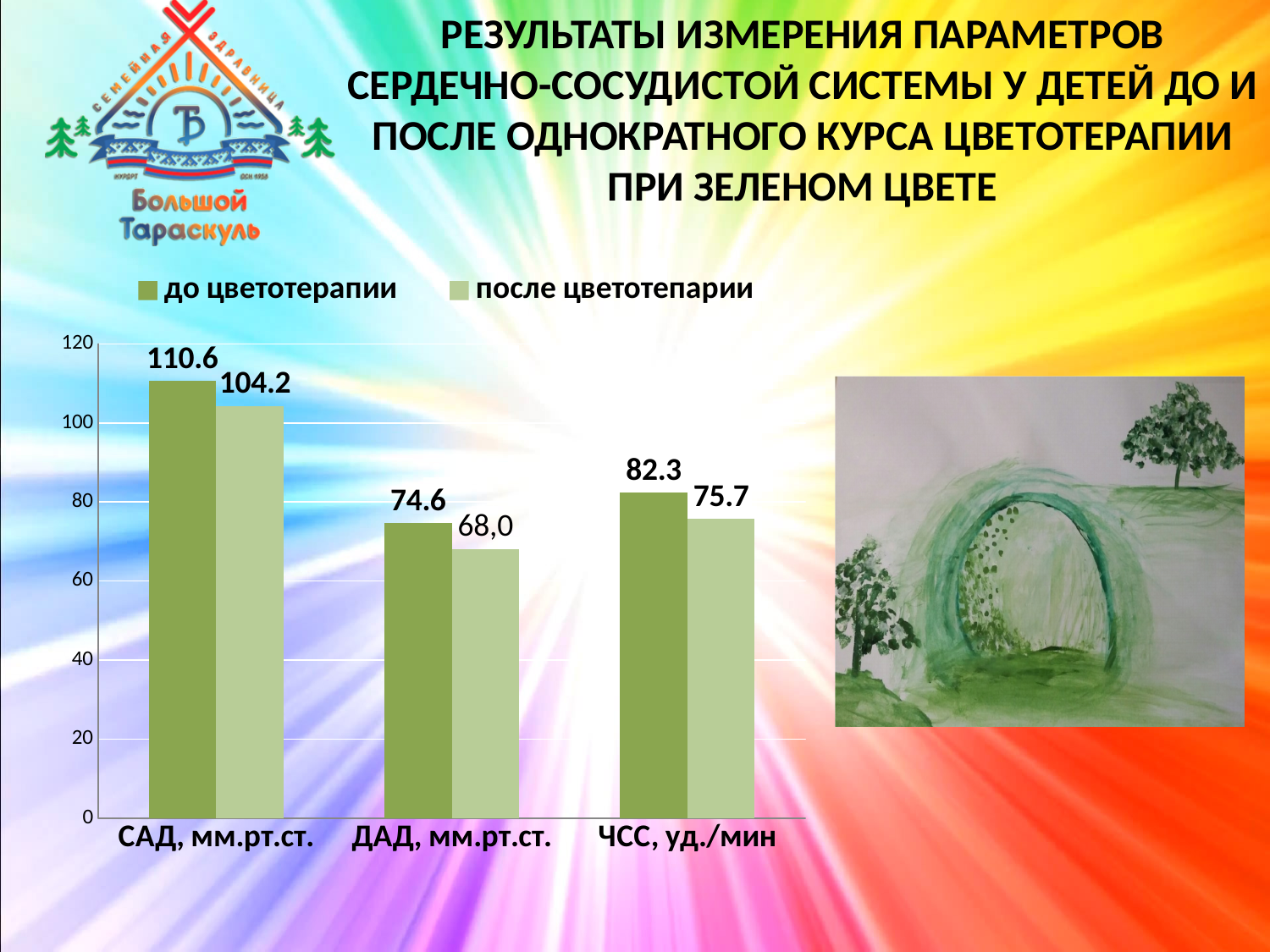
Which is larger for ДАД, мм.рт.ст.: the 'до цветотерапии' value or the 'после цветотепарии' value? до цветотерапии Which category has the highest value in the 'до цветотерапии' series? САД, мм.рт.ст. What is the value for ДАД, мм.рт.ст. in the 'после цветотепарии' series? 68,0 What is the difference between the 'до цветотерапии' and 'после цветотепарии' values for САД, мм.рт.ст.? 6.4 What is the value for ЧСС, уд./мин in the 'до цветотерапии' series? 82.3 What is the value for САД, мм.рт.ст. in the 'до цветотерапии' series? 110.6 Which category has the lowest value in the 'после цветотепарии' series? ДАД, мм.рт.ст. How many series does the chart legend list? 2 What is the difference between the 'до цветотерапии' and 'после цветотепарии' values for ЧСС, уд./мин? 6.6 What kind of chart is shown on the slide? bar chart What is the value for ЧСС, уд./мин in the 'после цветотепарии' series? 75.7 How many categories are shown on the x axis of the chart? 3